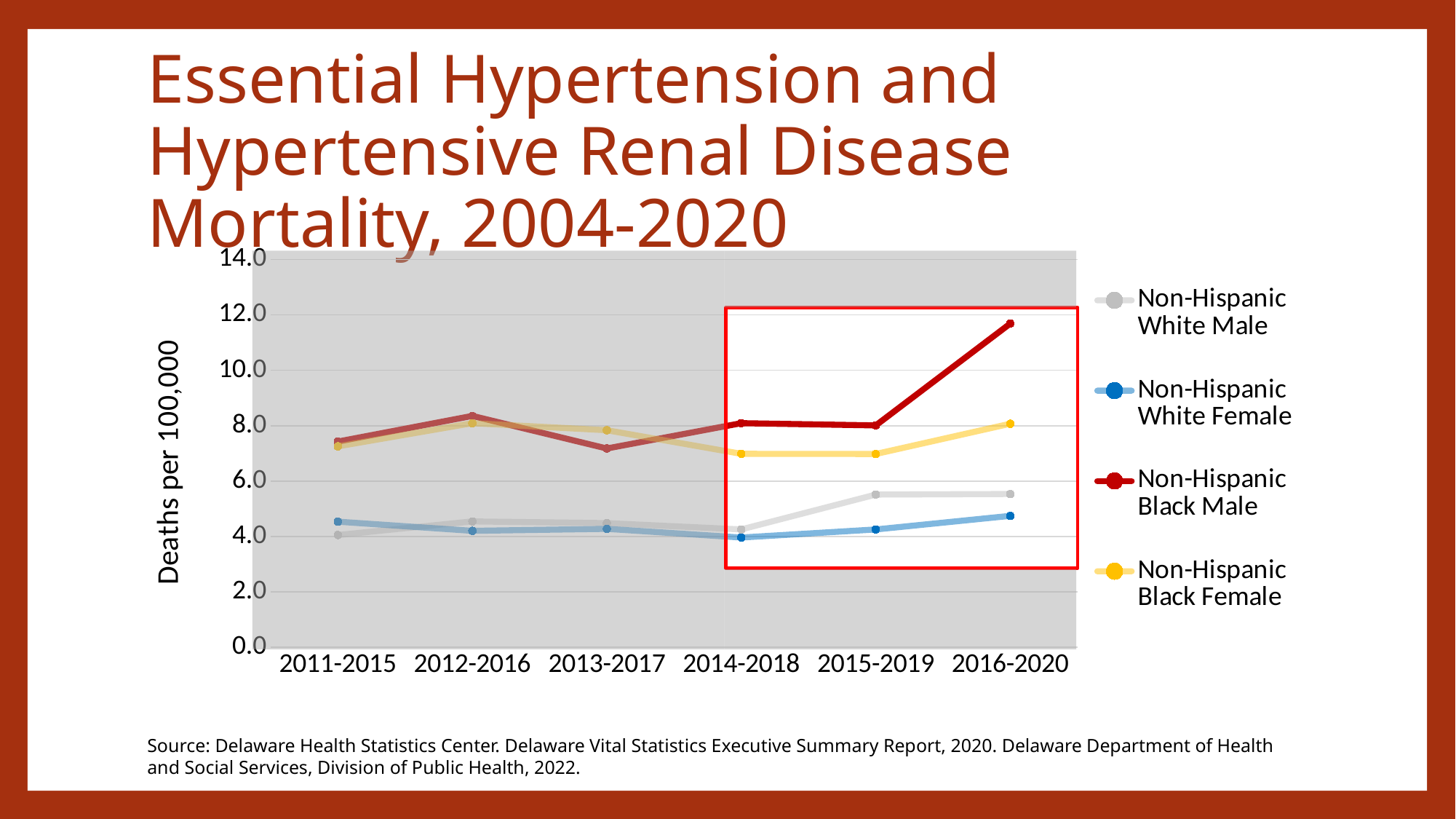
Is the value for Non-Hispanic Black Female in 2015-2019 greater or less than 6.0? greater Is the value for Non-Hispanic Black Male in 2016-2020 greater or less than 10.0? greater In 2016-2020, which is larger: the value for Non-Hispanic Black Male or Non-Hispanic Black Female? Non-Hispanic Black Male How many time periods are shown on the x axis? 6 Does the Non-Hispanic Black Male line rise or fall from 2015-2019 to 2016-2020? rise What kind of chart is shown on the slide? line chart Which colour represents Non-Hispanic Black Female in the legend? yellow What is the label on the y axis? Deaths per 100,000 Is the value for Non-Hispanic White Male in 2011-2015 greater or less than 6.0? less Which group has the highest mortality rate in 2016-2020? Non-Hispanic Black Male Which group has the lowest mortality rate in 2016-2020? Non-Hispanic White Female How many series does the legend list? 4